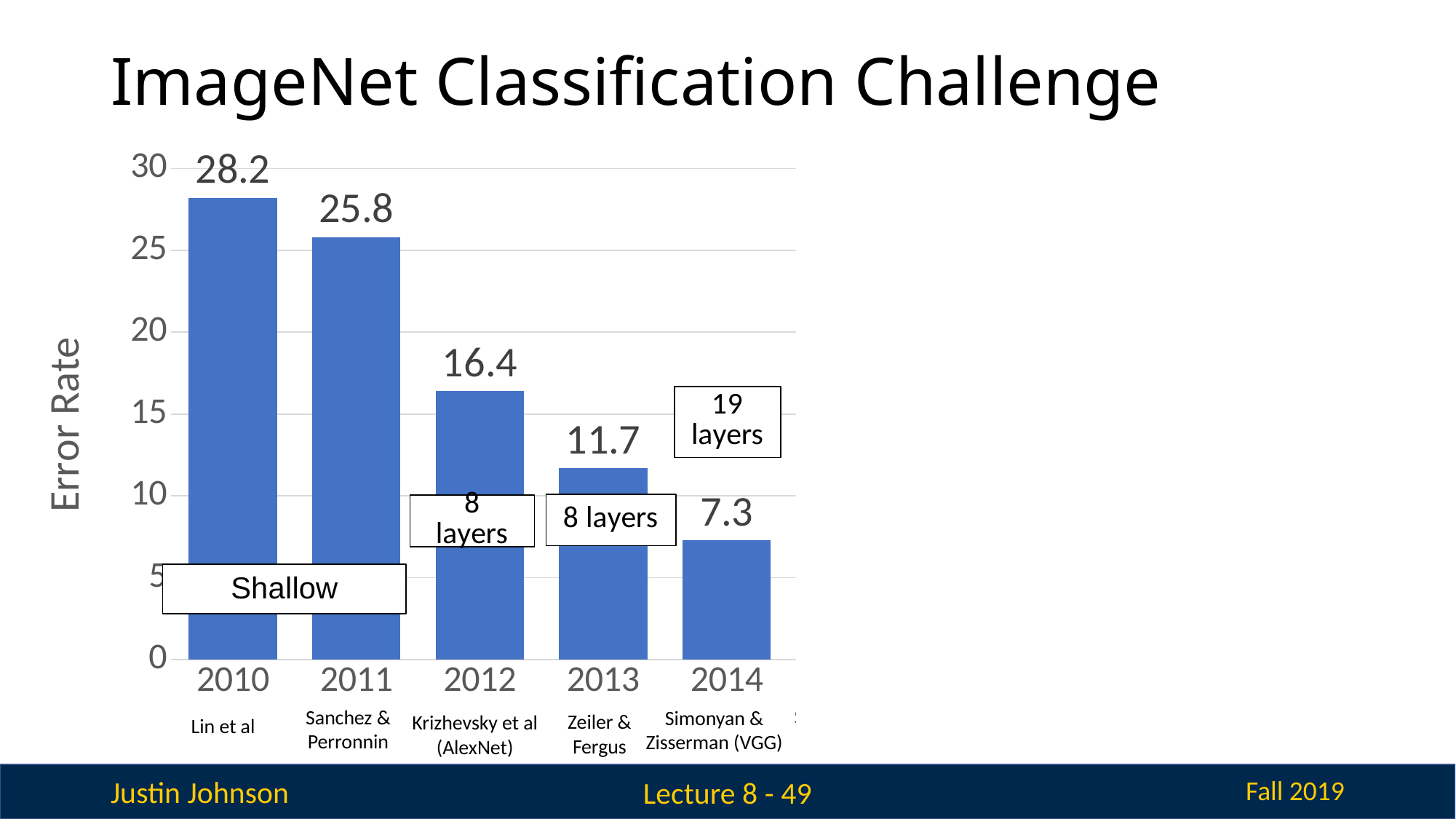
Which year has the highest error rate? 2010 What is the difference in error rate between 2010 and 2011? 2.4 Do the error rates rise or fall from 2010 to 2014? fall What is the error rate for 2014? 7.3 What kind of chart is shown? bar chart Is the error rate for 2013 greater or less than 10? greater Which has a higher error rate, 2011 or 2013? 2011 What is the error rate for 2012? 16.4 What is the difference in error rate between 2012 and 2013? 4.7 Which year has the lowest error rate? 2014 What is the error rate for 2010? 28.2 How many years are shown on the x axis? 5